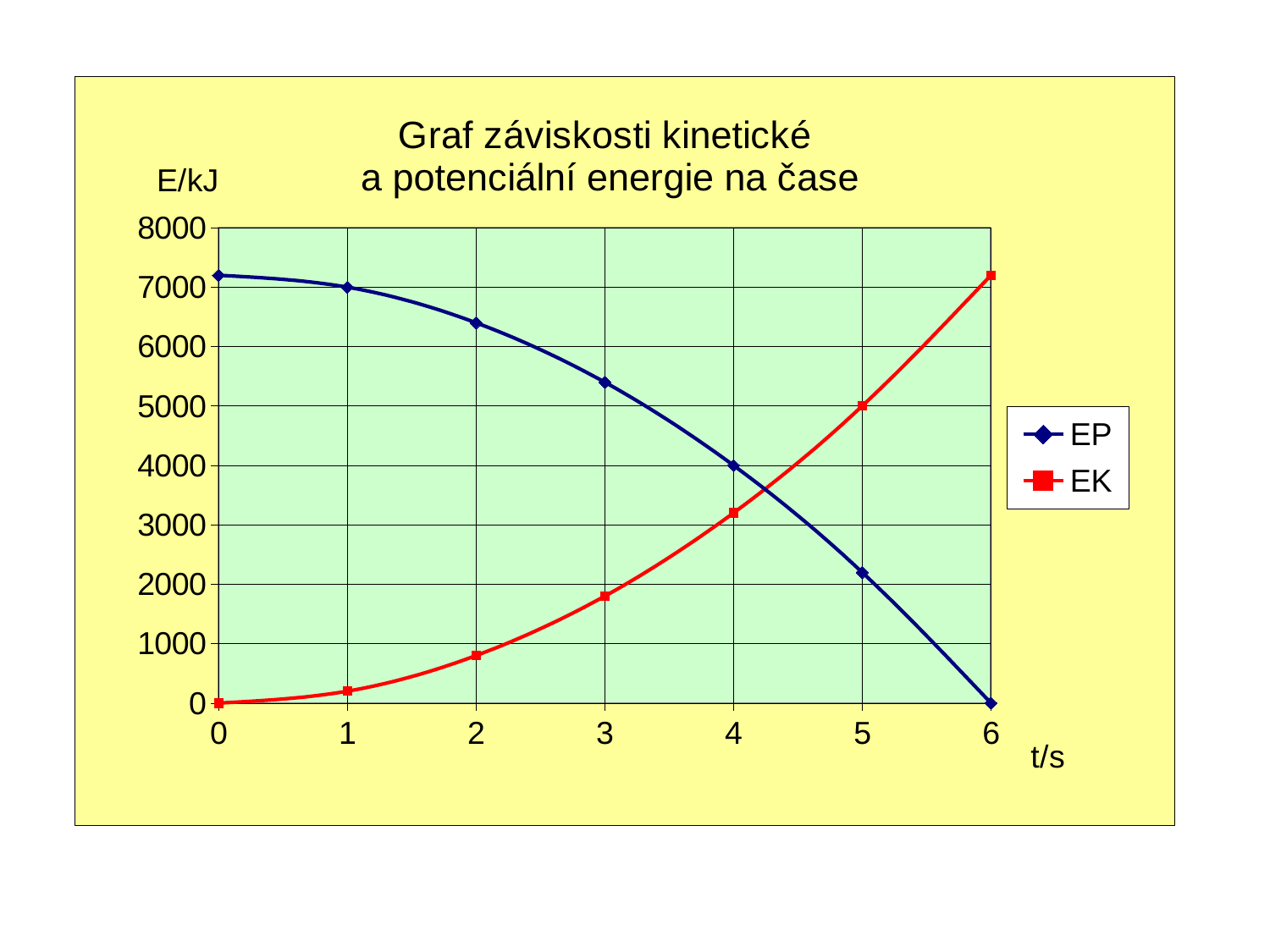
What is the value of EK at t = 5? 5000 Is the value of EK at t = 3 greater or less than 2000? less How many time points are plotted for each series? 7 What is the value of EK at t = 0? 0 Is the value of EP at t = 2 greater or less than 6000? greater What kind of chart is shown on the slide? line chart What is the value of EP at t = 4? 4000 At which value of t does EK reach its highest value? 6 At t = 3, which series has the larger value, EP or EK? EP Does the EP series rise or fall as t increases from 0 to 6? fall Does the EK series rise or fall as t increases from 0 to 6? rise How many series does the legend list? 2